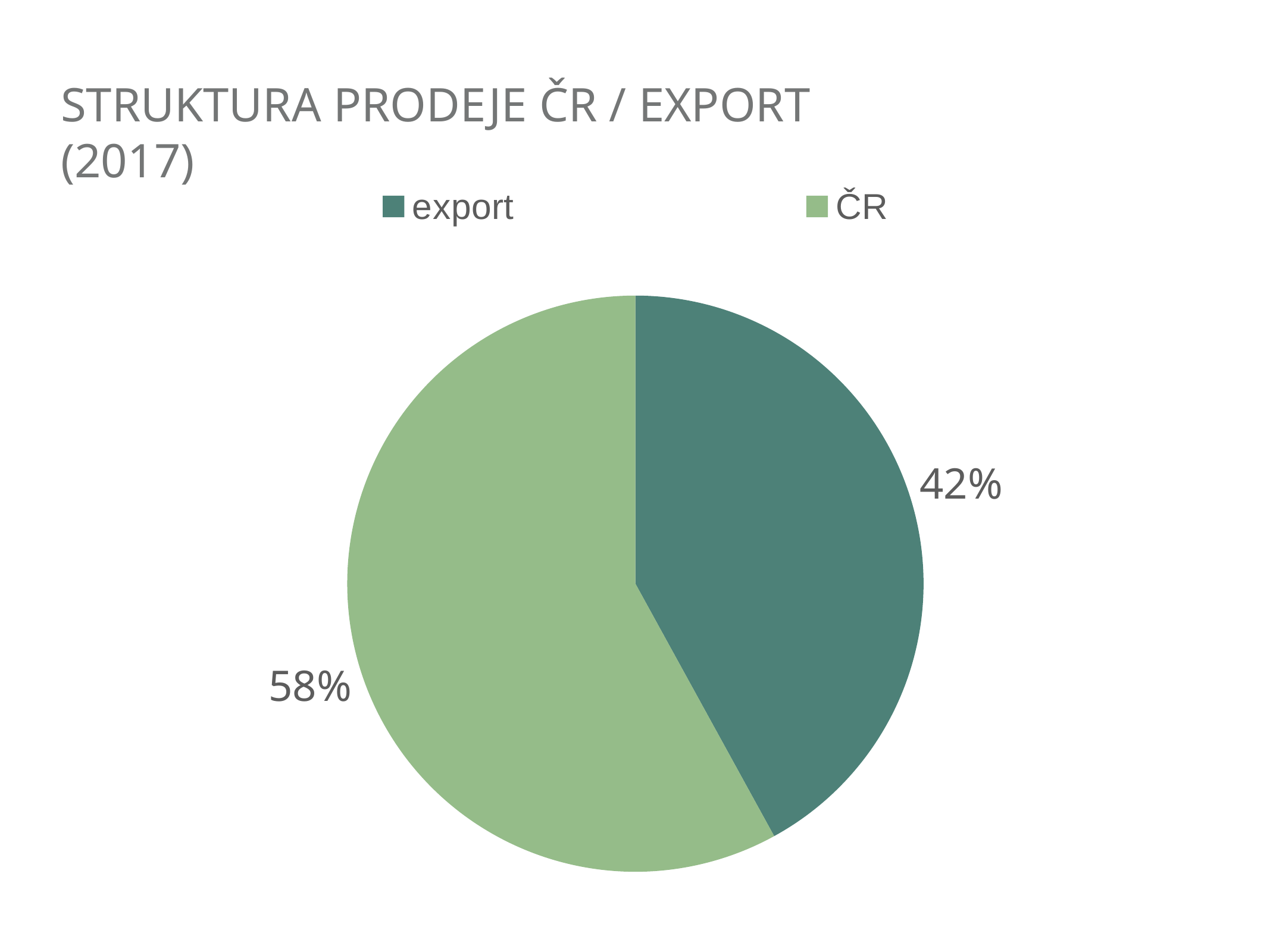
How many entries does the legend list? 2 Which slice is the largest in the pie chart? ČR Which is larger, the export slice or the ČR slice? ČR Is the share of the export slice greater or less than 50%? less What is the title of the chart? STRUKTURA PRODEJE ČR / EXPORT (2017) Which slice is the smallest in the pie chart? export What share of the pie does the export slice represent? 42% What share of the pie does the ČR slice represent? 58% What kind of chart is shown on the slide? pie chart How many slices does the pie chart have? 2 Which legend entry is shown in the darker green colour? export What is the difference in percentage points between the ČR slice and the export slice? 16